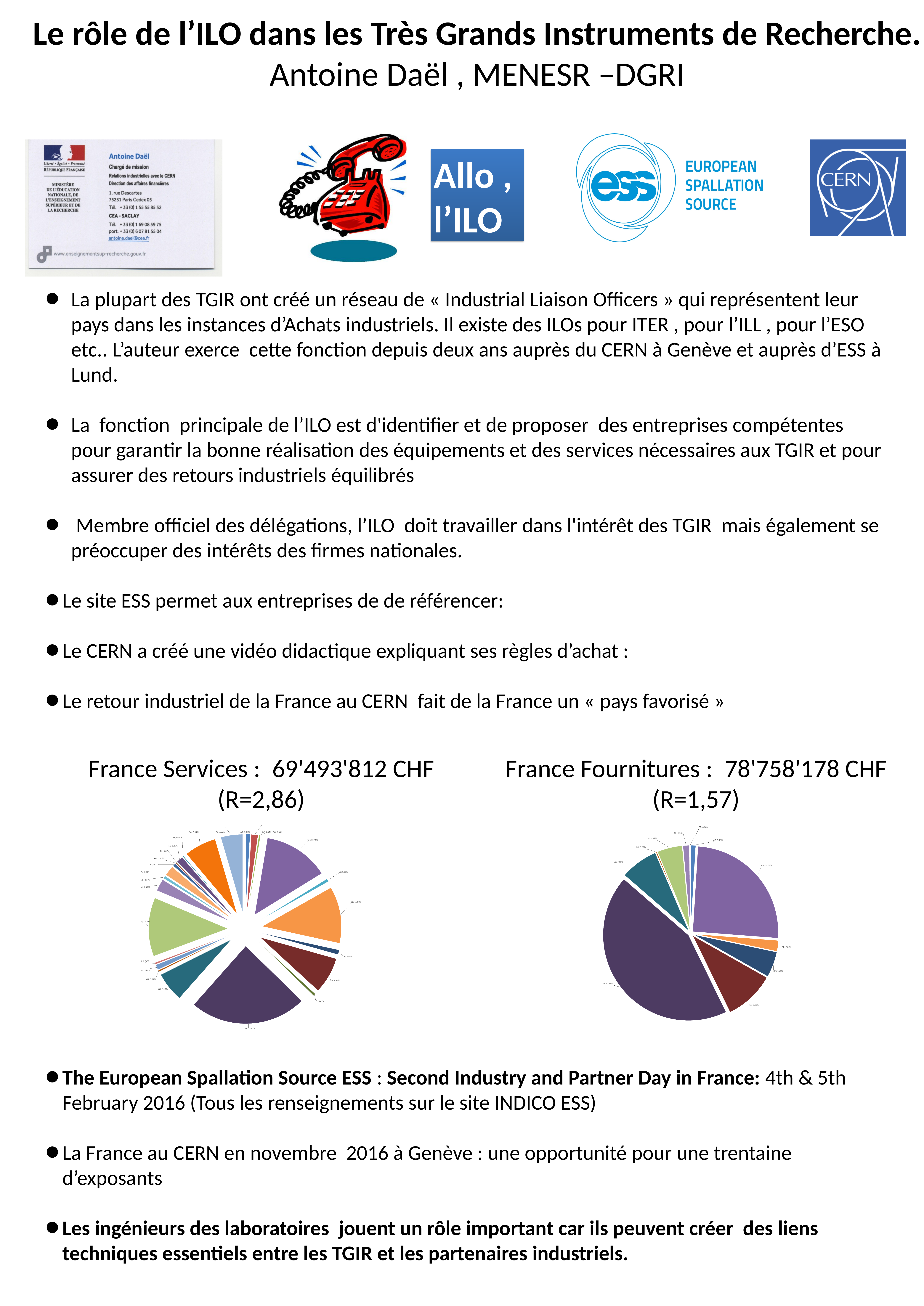
What total amount in CHF is given in the title of the 'France Services' chart? 69'493'812 CHF What R value is given in the title of the 'France Fournitures' chart? 1,57 How many pie charts are shown on the slide? 2 What kind of chart is the 'France Services' chart? pie chart What is the title of the chart on the right? France Fournitures : 78'758'178 CHF (R=1,57) What is the difference in CHF between the 'France Fournitures' total and the 'France Services' total shown in the chart titles? 9'264'366 CHF Which chart has the higher R value in its title, 'France Services' or 'France Fournitures'? France Services What total amount in CHF is given in the title of the 'France Fournitures' chart? 78'758'178 CHF What kind of chart is the 'France Fournitures' chart? pie chart Which chart title shows the larger CHF total, 'France Services' or 'France Fournitures'? France Fournitures What is the title of the chart on the left? France Services : 69'493'812 CHF (R=2,86) What R value is given in the title of the 'France Services' chart? 2,86